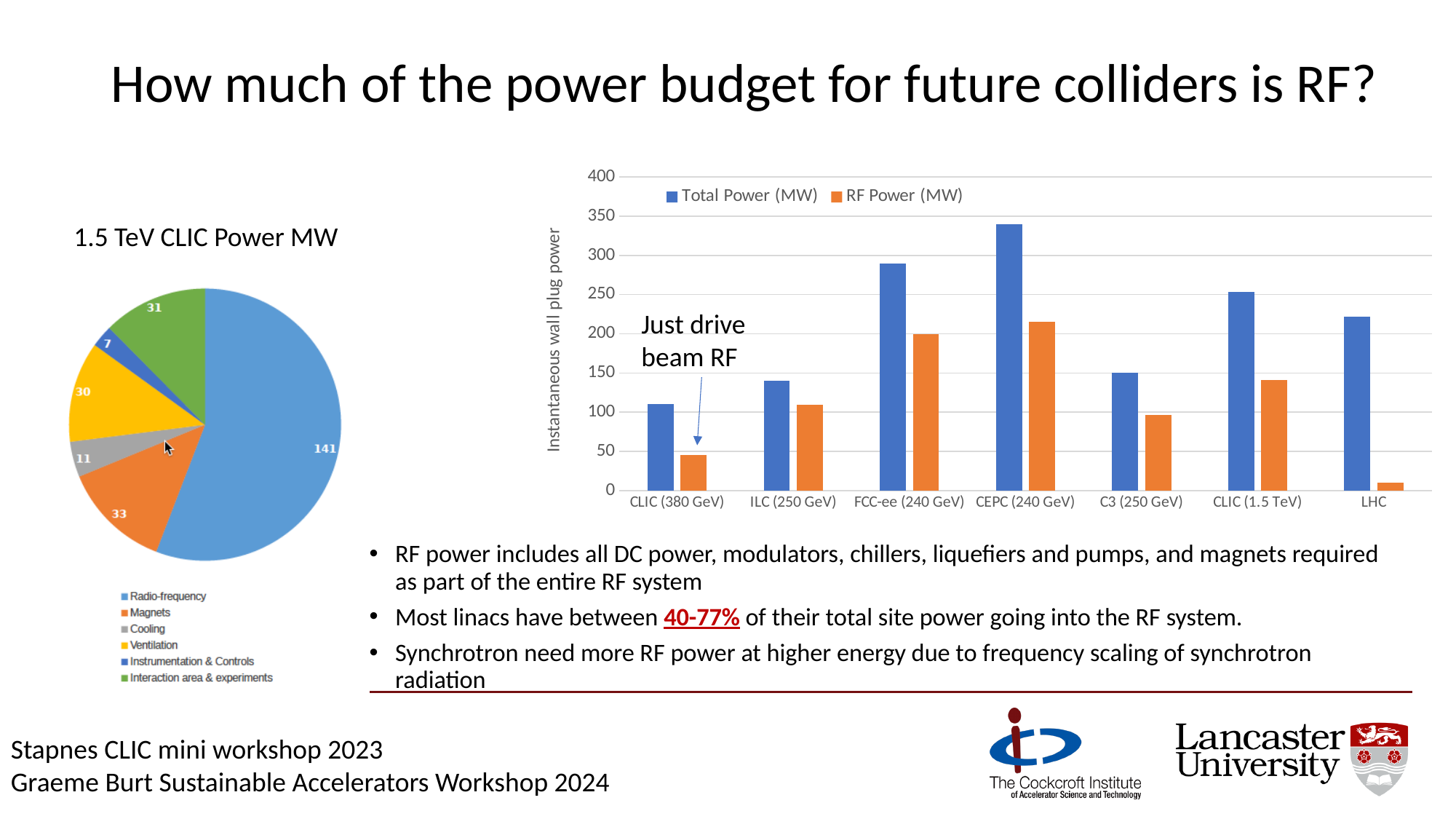
In the pie chart titled '1.5 TeV CLIC Power MW', which is larger, Interaction area & experiments or Ventilation? Interaction area & experiments In the bar chart on the right, which collider has the highest Total Power (MW)? CEPC (240 GeV) In the pie chart titled '1.5 TeV CLIC Power MW', what is the difference between the Ventilation value and the Cooling value? 19 In the pie chart titled '1.5 TeV CLIC Power MW', what is the value for Magnets? 33 In the pie chart titled '1.5 TeV CLIC Power MW', what is the value for Radio-frequency? 141 In the bar chart on the right, what is the label of the y axis? Instantaneous wall plug power In the bar chart on the right, how many series does the legend list? 2 In the bar chart on the right, is the Total Power (MW) for CEPC (240 GeV) greater or less than 300? greater In the pie chart titled '1.5 TeV CLIC Power MW', which category has the smallest slice? Instrumentation & Controls In the bar chart on the right, which collider has the lowest RF Power (MW)? LHC In the pie chart titled '1.5 TeV CLIC Power MW', how many categories does the legend list? 6 In the bar chart on the right, how many colliders are shown on the x axis? 7